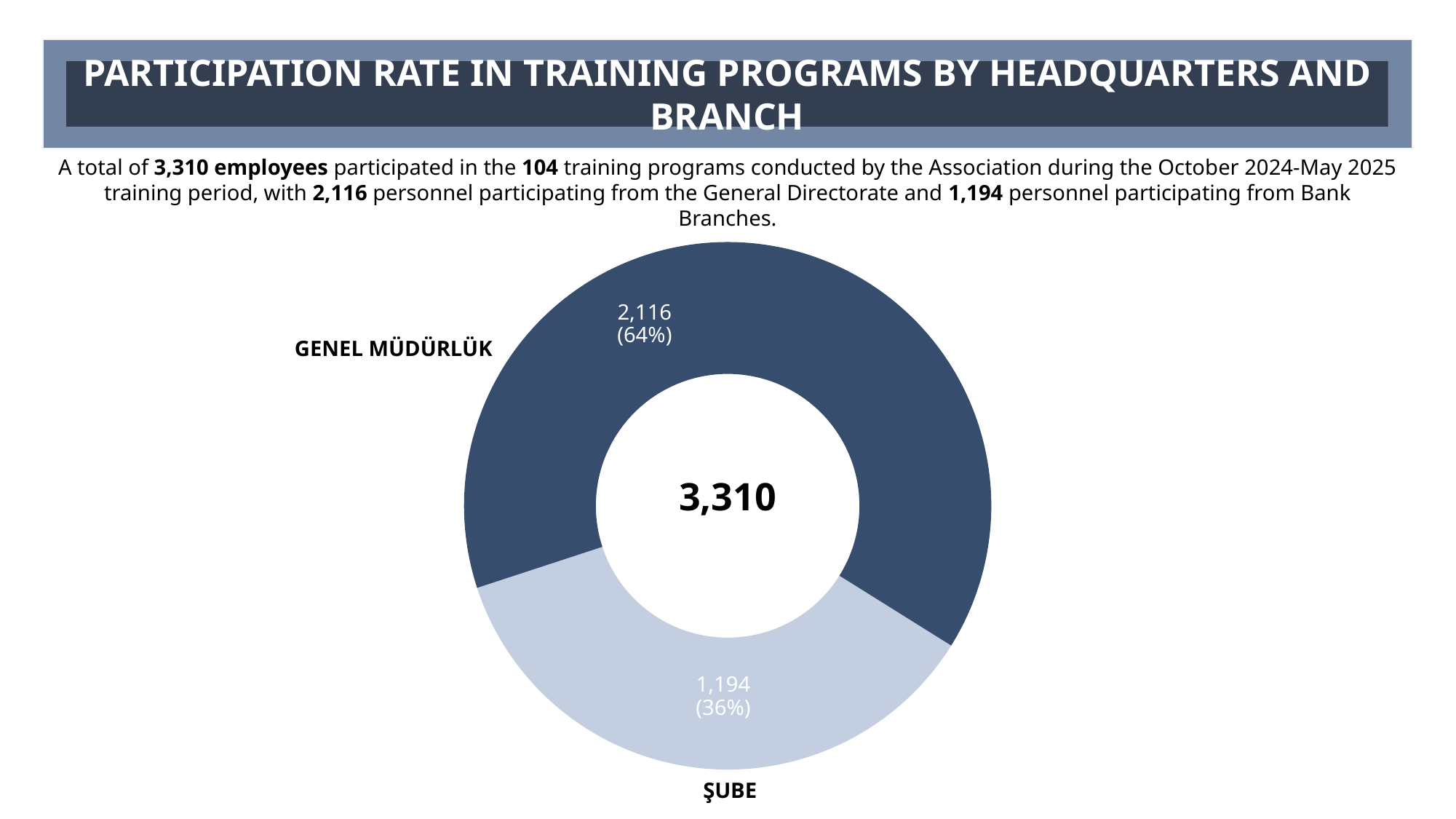
How many participants does the chart show for GENEL MÜDÜRLÜK? 2,116 How many categories does the chart show? 2 What kind of chart is shown on the slide? Doughnut (pie) chart What is the difference in participants between GENEL MÜDÜRLÜK and ŞUBE? 922 Is the value for ŞUBE larger or smaller than the value for GENEL MÜDÜRLÜK? smaller What is the title of the slide containing the chart? PARTICIPATION RATE IN TRAINING PROGRAMS BY HEADQUARTERS AND BRANCH What share of the chart does the GENEL MÜDÜRLÜK slice represent? 64% How many participants does the chart show for ŞUBE? 1,194 What share of the chart does the ŞUBE slice represent? 36% Which category has the smaller slice in the chart? ŞUBE What is the total number shown in the centre of the chart? 3,310 Which category has the larger slice in the chart? GENEL MÜDÜRLÜK